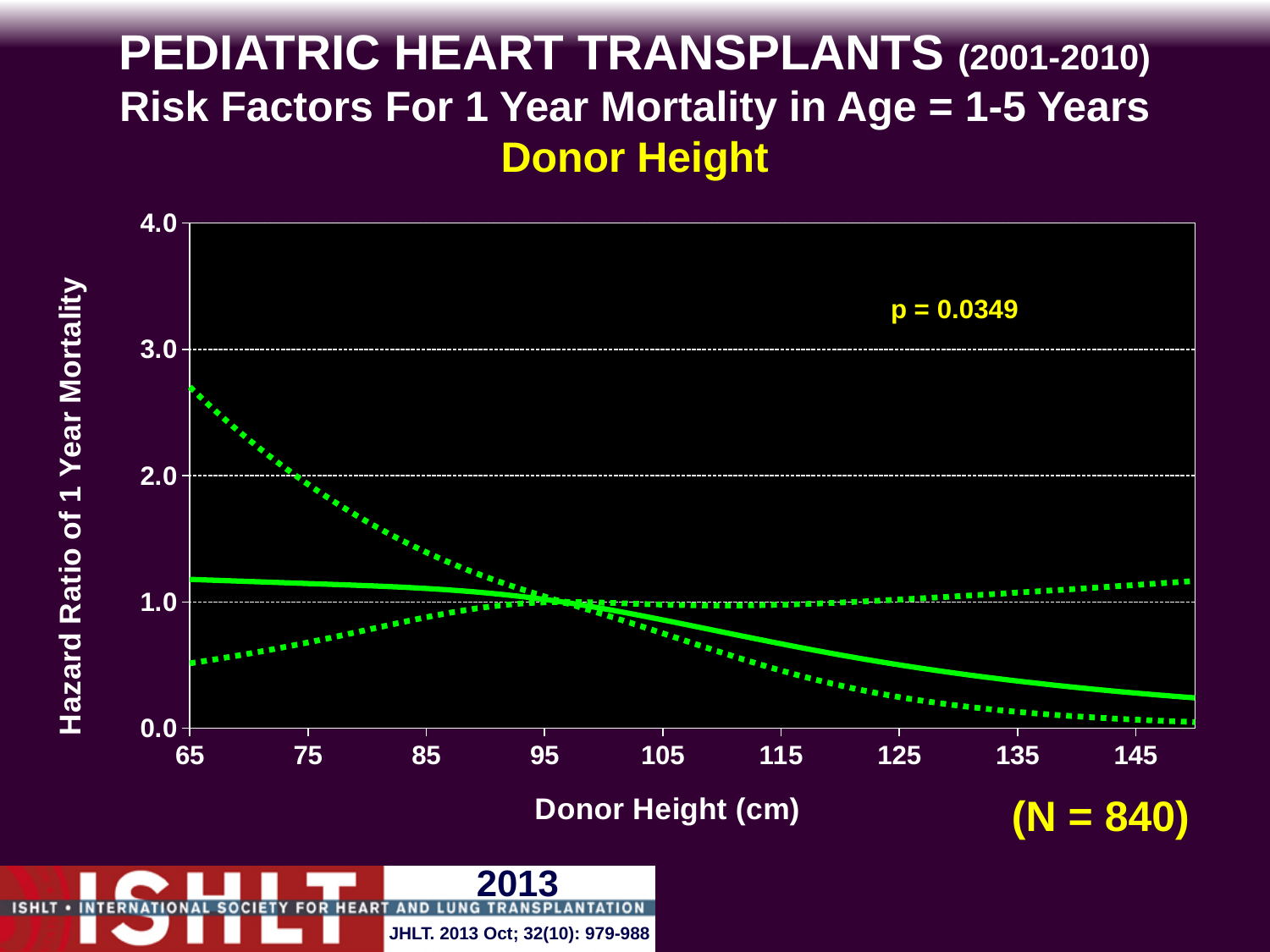
Is the value of the upper dotted line at a donor height of 105 cm greater or less than 2.0? less Is the solid line's value at a donor height of 65 cm larger or smaller than its value at 145 cm? larger What sample size (N) is printed on the slide? N = 840 Is the value of the solid hazard ratio line at a donor height of 145 cm greater or less than 1.0? less What p-value is printed on the chart? p = 0.0349 Is the value of the lower dotted line at a donor height of 145 cm greater or less than 1.0? less How many tick labels are shown on the x axis (Donor Height)? 9 Does the solid line (hazard ratio) rise or fall as donor height increases from 65 cm to 145 cm? fall What kind of chart is shown on the slide? line chart What is the highest value labelled on the y axis? 4.0